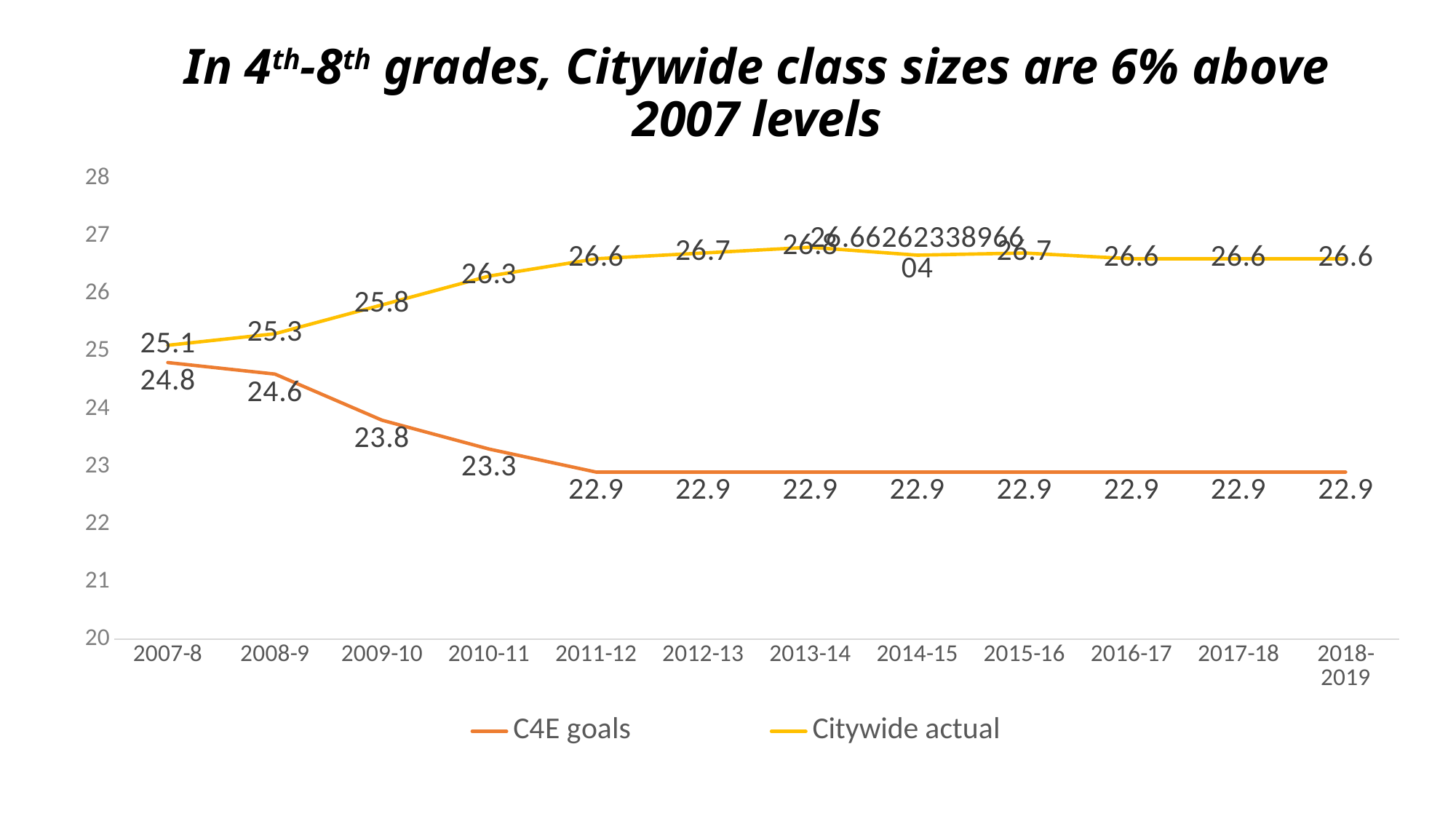
What is the Citywide actual value for 2018-2019? 26.6 What are the two entries in the legend? C4E goals and Citywide actual In 2009-10, which series has the larger value, C4E goals or Citywide actual? Citywide actual What is the difference between the Citywide actual and C4E goals values in 2018-2019? 3.7 Is the Citywide actual value for 2012-13 greater or less than 26? greater In which school year is the Citywide actual value lowest? 2007-8 How many series does the legend list? 2 Do the C4E goals values rise or fall from 2007-8 to 2011-12? fall How many school years are plotted along the x axis? 12 What is the C4E goals value for 2010-11? 23.3 What kind of chart is shown on the slide? line chart What is the Citywide actual value for 2007-8? 25.1